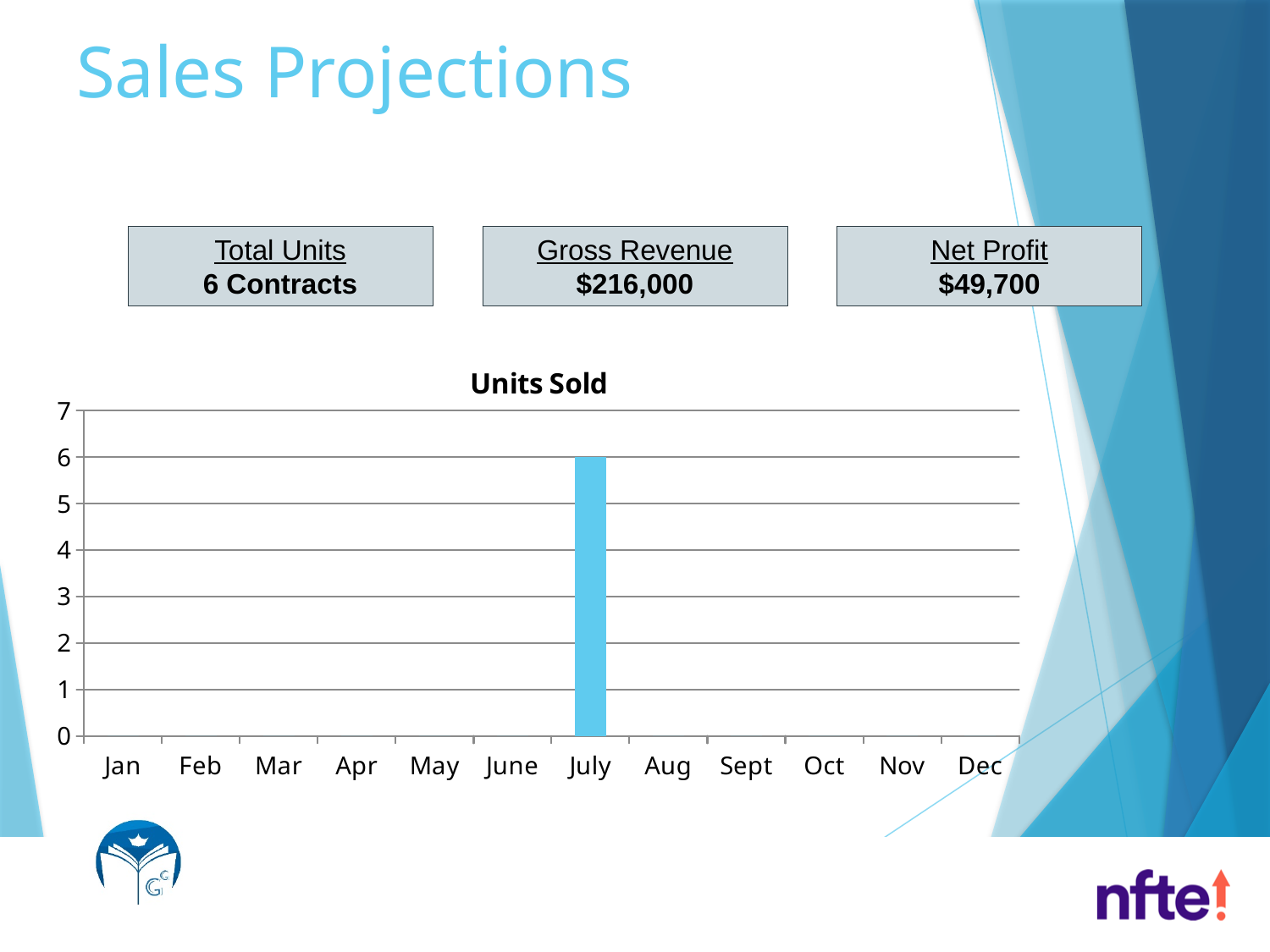
Is the value for July in the Units Sold chart greater or less than 5? greater What kind of chart is the Units Sold chart? bar chart Which month has the highest value in the Units Sold chart? July How many months in the Units Sold chart have a visible bar? 1 In the Units Sold chart, which is larger, the value for July or the value for Jan? July In the Units Sold chart, which is larger, the value for July or the value for Dec? July What is the highest value shown on the y axis of the Units Sold chart? 7 What is the title of the chart on the slide? Units Sold How many months are shown on the x axis of the Units Sold chart? 12 What is the value for July in the Units Sold chart? 6 Is the value for July in the Units Sold chart greater or less than 7? less